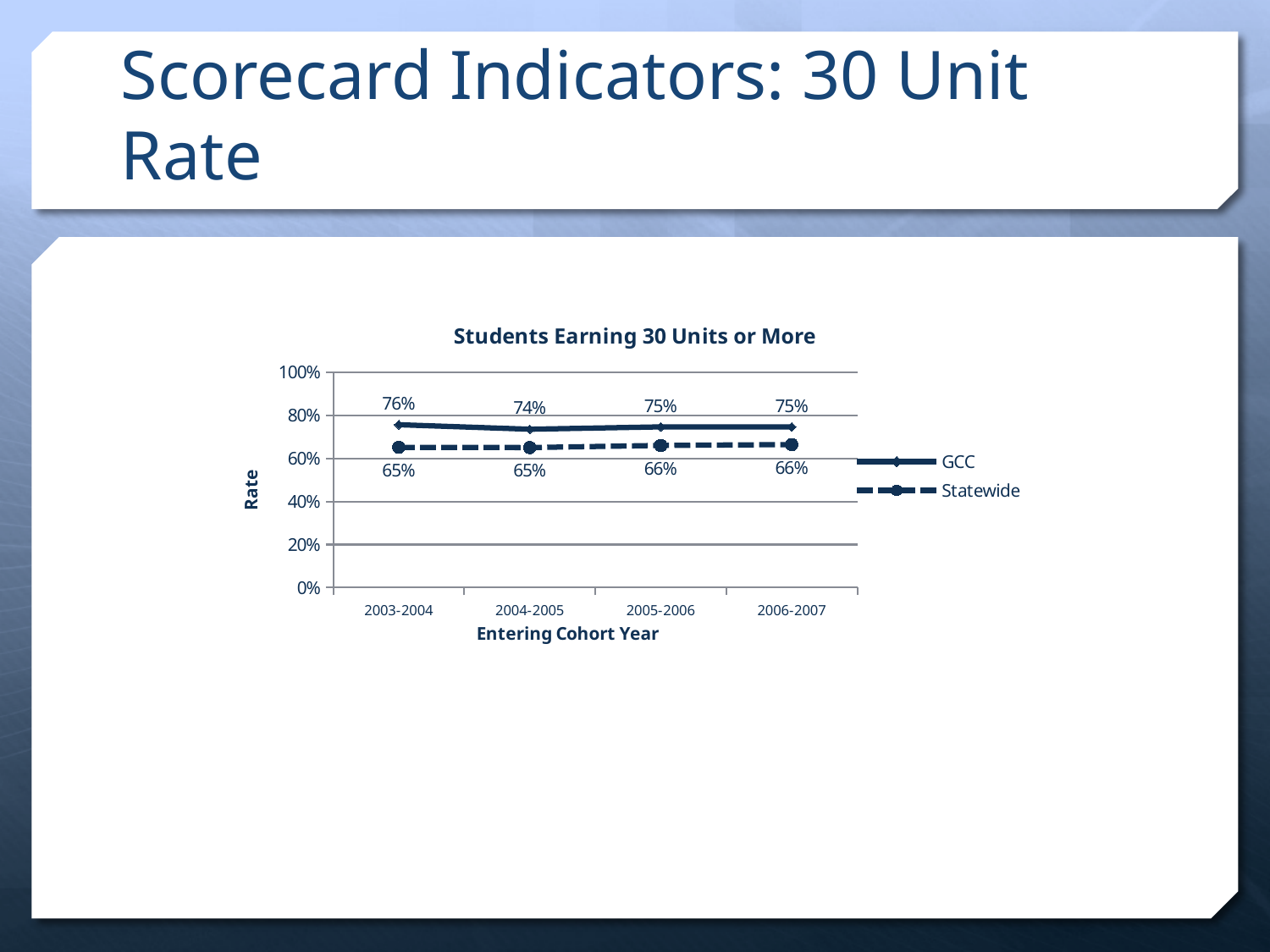
What is the GCC rate for the 2003-2004 entering cohort year? 76% What kind of chart is shown on the slide? line chart How many entering cohort years are shown on the x axis? 4 What is the GCC rate for the 2004-2005 entering cohort year? 74% What is the title of the chart? Students Earning 30 Units or More Which entering cohort year has the lowest GCC rate? 2004-2005 What is the Statewide rate for the 2005-2006 entering cohort year? 66% What is the difference between the GCC rate and the Statewide rate for 2003-2004? 11% Which entering cohort year has the highest GCC rate? 2003-2004 How many series does the legend list? 2 Is the Statewide rate for 2004-2005 greater or less than 80%? less Which series has the higher rate for 2006-2007, GCC or Statewide? GCC